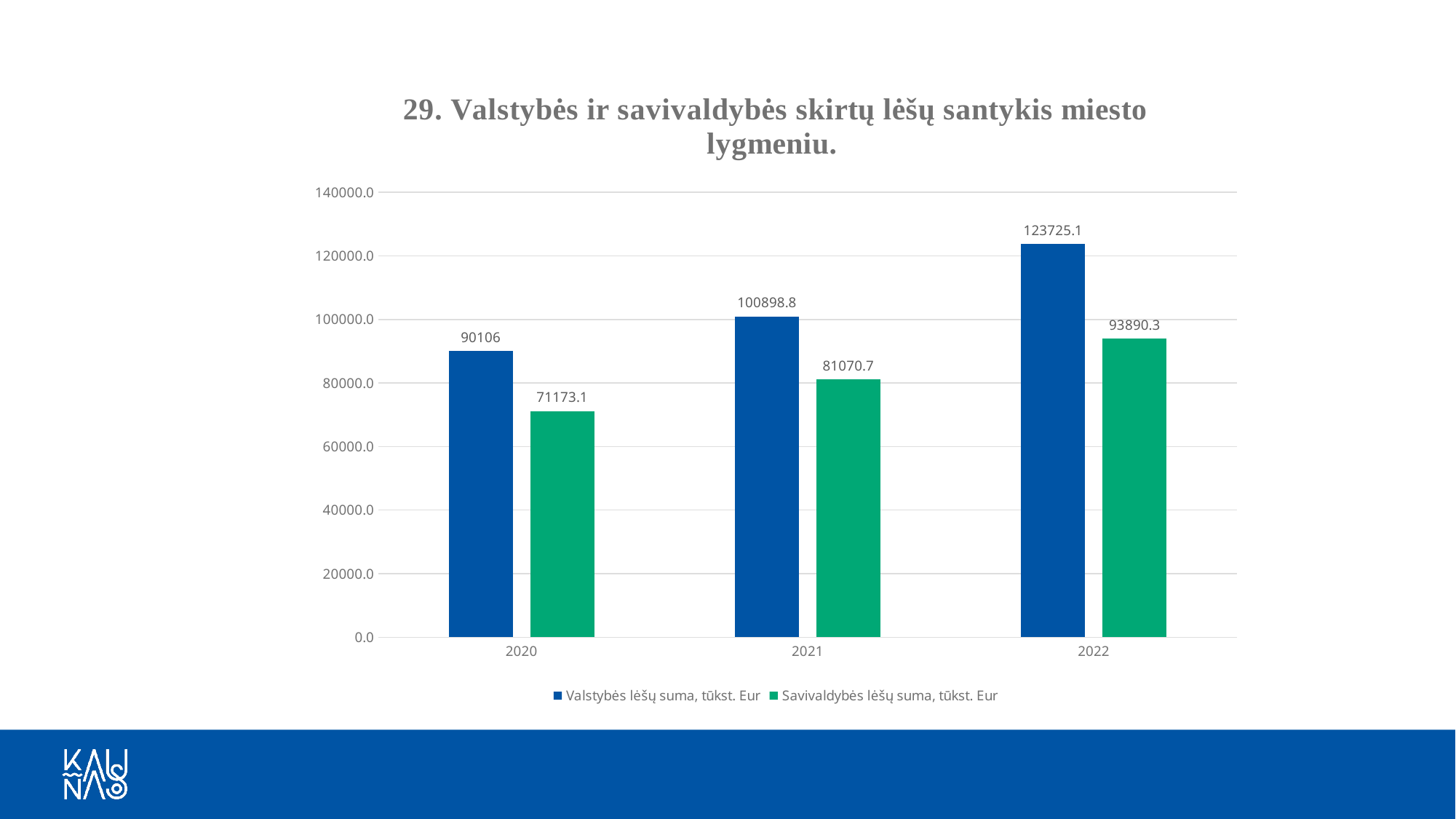
How many years are shown on the x axis? 3 What is the value of Savivaldybės lėšų suma, tūkst. Eur for 2021? 81070.7 What is the difference between Valstybės lėšų suma and Savivaldybės lėšų suma in 2022? 29834.8 What kind of chart is shown on the slide? Bar chart What is the value of Savivaldybės lėšų suma, tūkst. Eur for 2022? 93890.3 Which is larger in 2021: Valstybės lėšų suma or Savivaldybės lėšų suma? Valstybės lėšų suma By how much did Valstybės lėšų suma, tūkst. Eur increase from 2020 to 2022? 33619.1 How many series does the legend list? 2 What is the value of Valstybės lėšų suma, tūkst. Eur for 2020? 90106 Is the value of Valstybės lėšų suma, tūkst. Eur for 2021 greater or less than 100000.0? greater In which year is Savivaldybės lėšų suma, tūkst. Eur the lowest? 2020 In which year is Valstybės lėšų suma, tūkst. Eur the highest? 2022